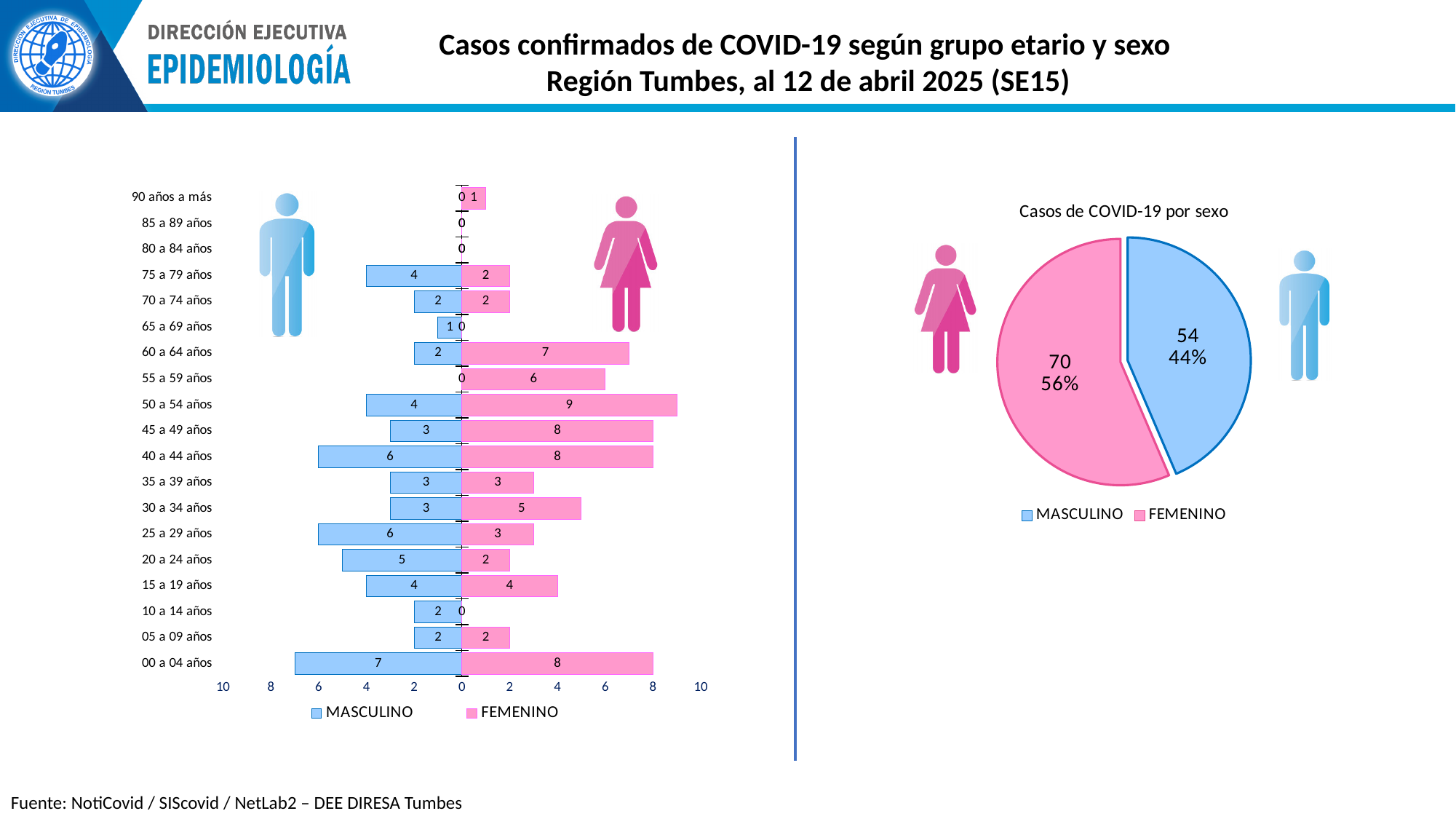
In the left chart, how many MASCULINO cases are there in the 00 a 04 años group? 7 In the 'Casos de COVID-19 por sexo' pie chart, how many MASCULINO cases are there? 54 In the left chart, how many age groups are shown on the vertical axis? 19 In the left chart, which age group has the highest number of FEMENINO cases? 50 a 54 años What kind of chart is the chart on the left side of the slide? Bar chart In the left chart, what is the difference between FEMENINO and MASCULINO cases in the 60 a 64 años group? 5 In the 'Casos de COVID-19 por sexo' pie chart, what share of cases is FEMENINO? 56% In the left chart, how many FEMENINO cases are there in the 50 a 54 años group? 9 In the left chart, how many series does the legend list? 2 In the left chart, which is larger in the 25 a 29 años group, MASCULINO or FEMENINO? MASCULINO In the left chart, which age group has the highest number of MASCULINO cases? 00 a 04 años In the 'Casos de COVID-19 por sexo' pie chart, what is the total number of cases across both slices? 124